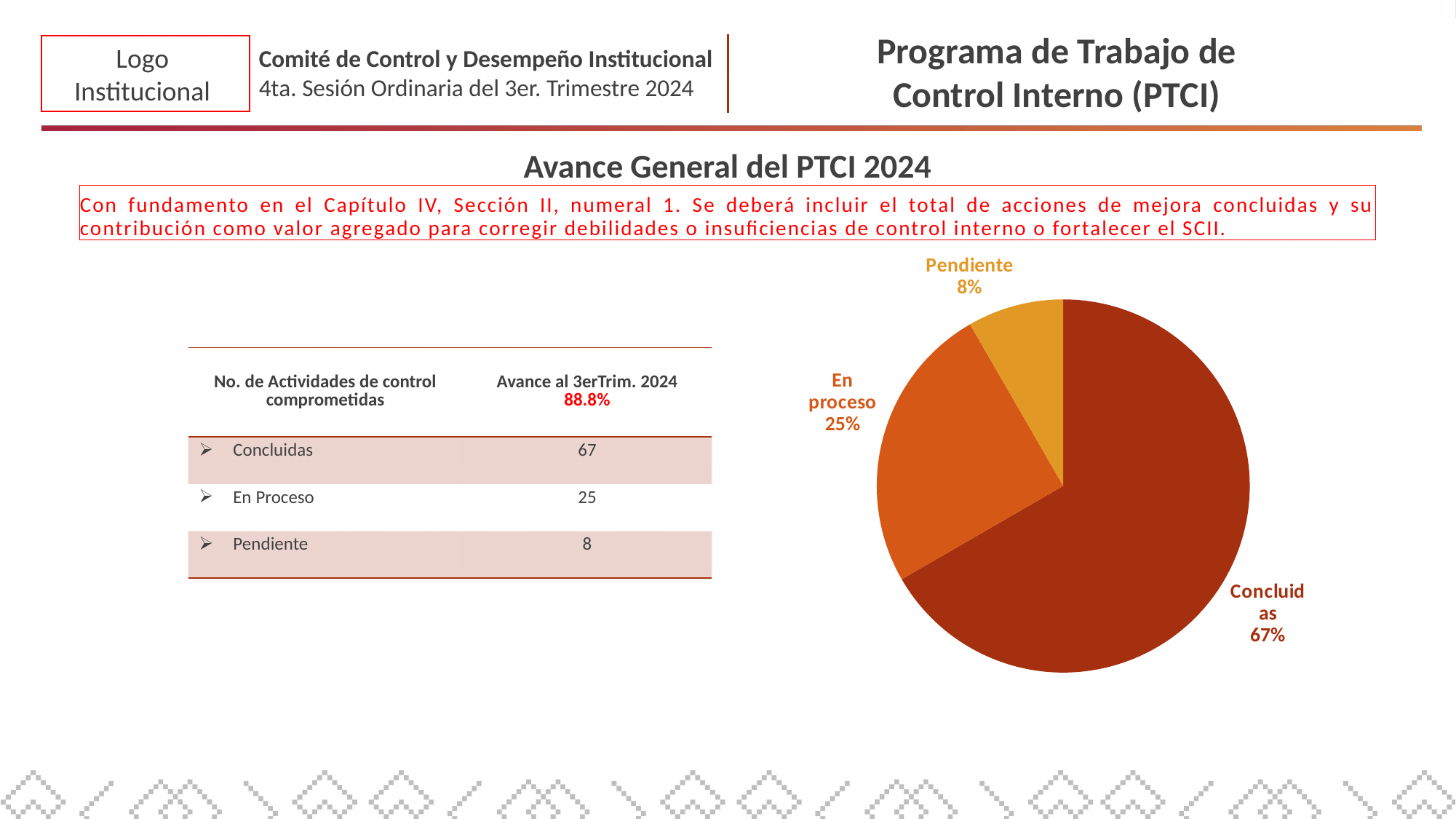
What percentage does the pie chart show for Pendiente? 8% What percentage does the pie chart show for En proceso? 25% What is the difference in percentage points between the Concluidas and En proceso slices? 42 What is the difference in percentage points between the En proceso and Pendiente slices? 17 Which slice of the pie chart is the smallest? Pendiente How many slices does the pie chart have? 3 What percentage does the pie chart show for Concluidas? 67% Which is larger in the pie chart, En proceso or Pendiente? En proceso Which slice of the pie chart is the largest? Concluidas What colour is the Pendiente slice of the pie chart? yellow-orange What kind of chart is shown on the slide? pie chart What colour is the Concluidas slice of the pie chart? dark red-brown